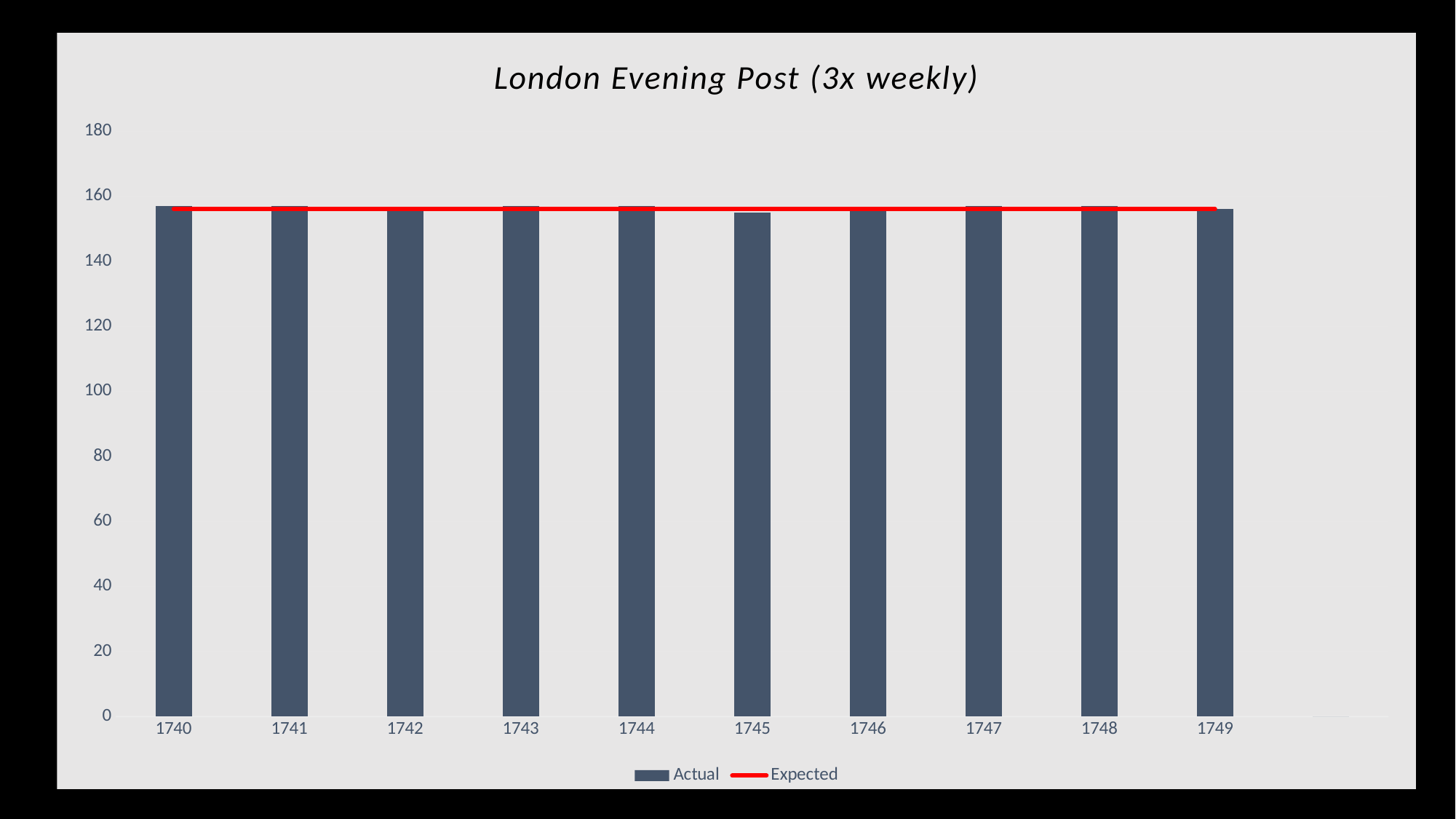
Do the Actual values rise, fall, or stay roughly flat from 1740 to 1749? roughly flat How many series does the chart legend list? 2 What is the title of the chart? London Evening Post (3x weekly) Is the Actual value for 1740 greater or less than 140? greater What kind of chart is shown on the slide? combination bar and line chart What is the highest value labelled on the y axis? 180 Is the Actual value for 1749 greater or less than 120? greater Is the Expected line greater or less than 160? less What are the two series named in the chart legend? Actual and Expected What is the first year shown on the x axis? 1740 How many years are shown along the x axis of the chart? 10